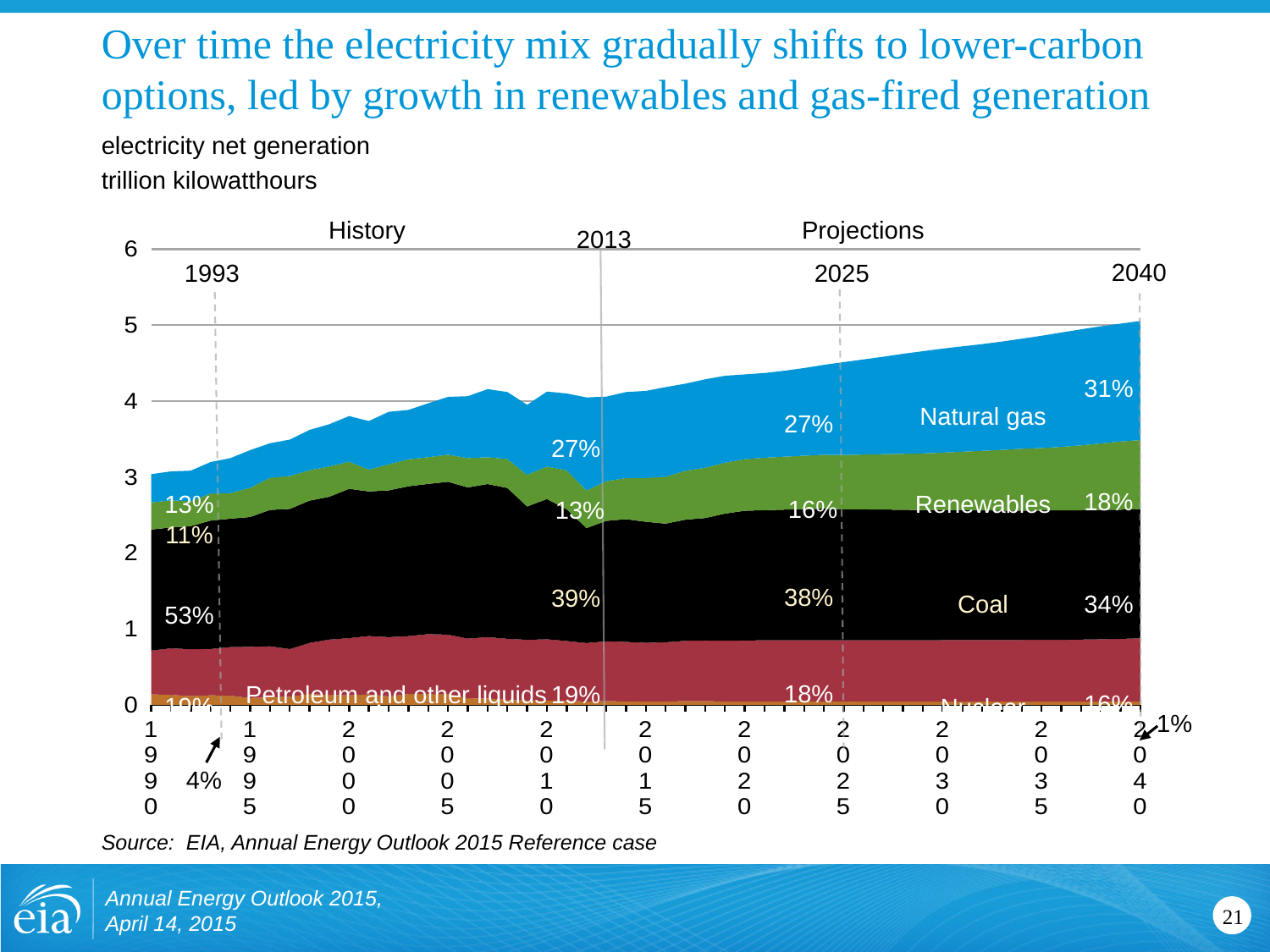
By how many percentage points does coal's share of electricity net generation fall between 1993 and 2040? 19 percentage points What share of electricity net generation does petroleum and other liquids account for in 1993? 4% Which fuel has the largest share of electricity net generation in 2013? Coal Does the share of natural gas in electricity net generation rise or fall from 1993 to 2040? Rise In 2025, which has the larger share of electricity net generation, natural gas or renewables? Natural gas What share of electricity net generation do renewables account for in 2025? 16% What kind of chart is shown on the slide? Stacked area chart How many fuel categories are shown in the chart? 5 What share of electricity net generation is projected for natural gas in 2040? 31% Is total electricity net generation in 1993 greater or less than 4 trillion kilowatthours? less What share of electricity net generation does nuclear account for in 2040? 16% What share of electricity net generation does coal account for in 1993? 53%